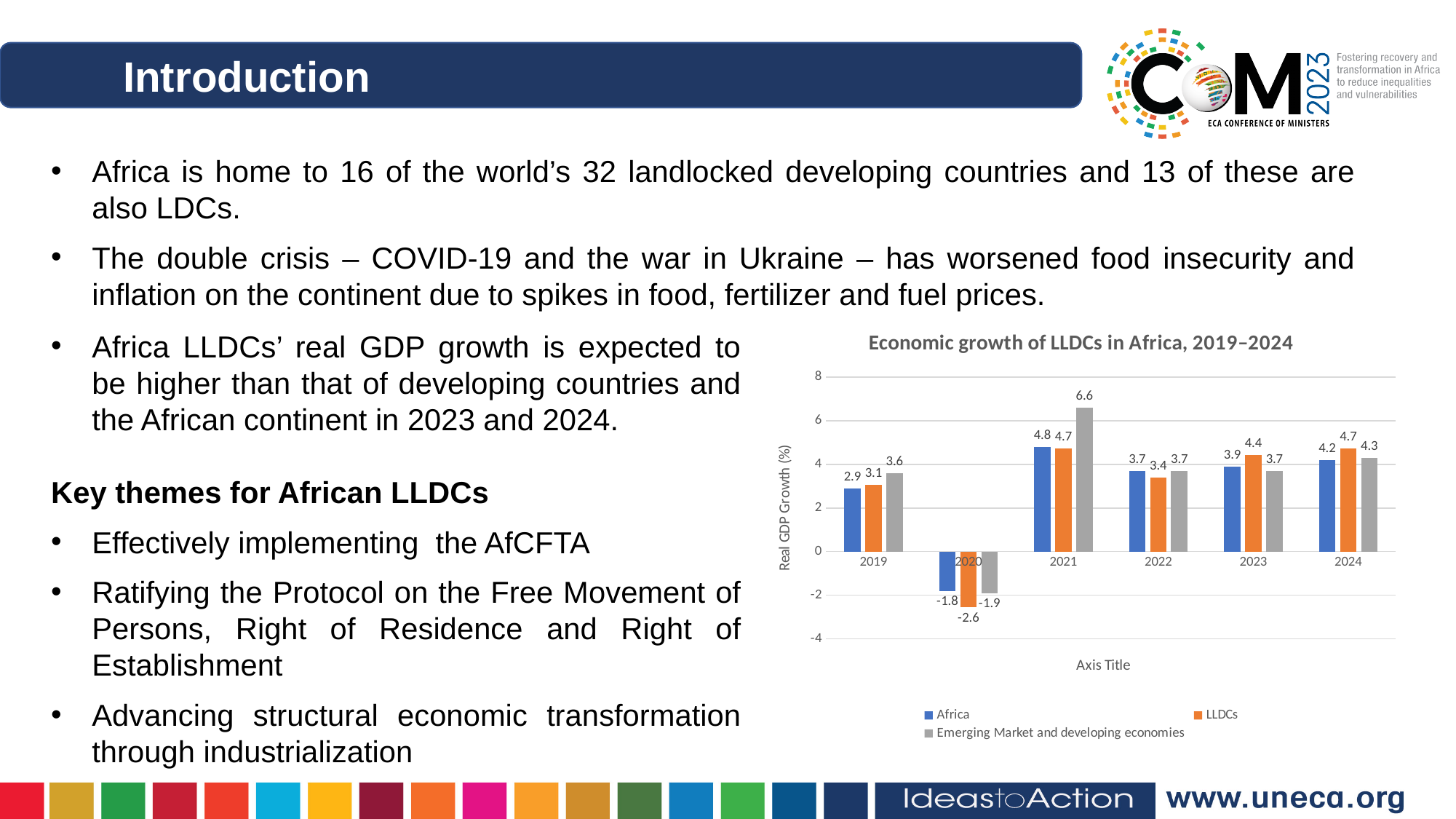
Does the value for LLDCs rise or fall from 2022 to 2024? rise In which year is the value for LLDCs lowest? 2020 What type of chart is shown on the slide? bar chart What is the difference between the LLDCs value and the Africa value in 2023? 0.5 What is the real GDP growth value for Africa in 2021? 4.8 How many years are shown on the x axis of the chart? 6 What is the real GDP growth value for LLDCs in 2020? -2.6 In which year is the value for Emerging Market and developing economies highest? 2021 In 2019, which is larger: the value for Africa or the value for Emerging Market and developing economies? Emerging Market and developing economies How many series does the chart legend list? 3 What is the value for Emerging Market and developing economies in 2024? 4.3 What is the title of the chart? Economic growth of LLDCs in Africa, 2019–2024